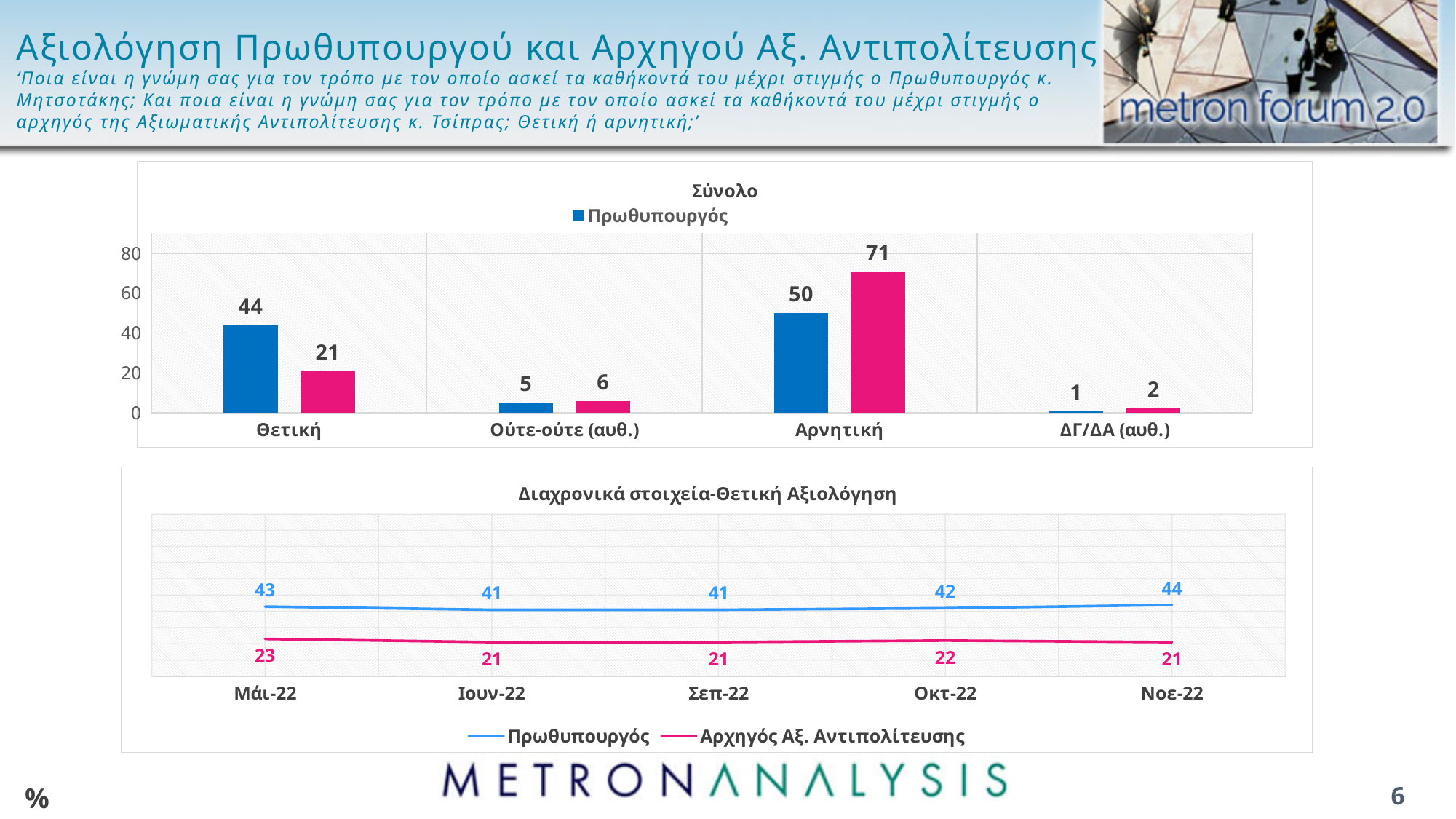
In the top chart titled 'Σύνολο', what is the difference between the pink bar and the blue bar for Αρνητική? 21 In the top chart titled 'Σύνολο', which category has the lowest value for the Πρωθυπουργός series? ΔΓ/ΔΑ (αυθ.) What kind of chart is the top chart titled 'Σύνολο'? Bar chart In the bottom chart 'Διαχρονικά στοιχεία-Θετική Αξιολόγηση', what is the difference between Πρωθυπουργός and Αρχηγός Αξ. Αντιπολίτευσης in Νοε-22? 23 In the bottom chart 'Διαχρονικά στοιχεία-Θετική Αξιολόγηση', what is the value for Πρωθυπουργός in Νοε-22? 44 In the bottom chart 'Διαχρονικά στοιχεία-Θετική Αξιολόγηση', how many series does the legend list? 2 In the top chart titled 'Σύνολο', how many categories are shown on the x axis? 4 In the top chart titled 'Σύνολο', what is the value of the Πρωθυπουργός (blue) bar for Αρνητική? 50 In the bottom chart 'Διαχρονικά στοιχεία-Θετική Αξιολόγηση', what is the value for Αρχηγός Αξ. Αντιπολίτευσης in Μάι-22? 23 In the top chart titled 'Σύνολο', what is the value of the pink bar for Θετική? 21 In the bottom chart 'Διαχρονικά στοιχεία-Θετική Αξιολόγηση', which is larger in Οκτ-22: Πρωθυπουργός or Αρχηγός Αξ. Αντιπολίτευσης? Πρωθυπουργός In the top chart titled 'Σύνολο', which category has the highest value for the pink series? Αρνητική